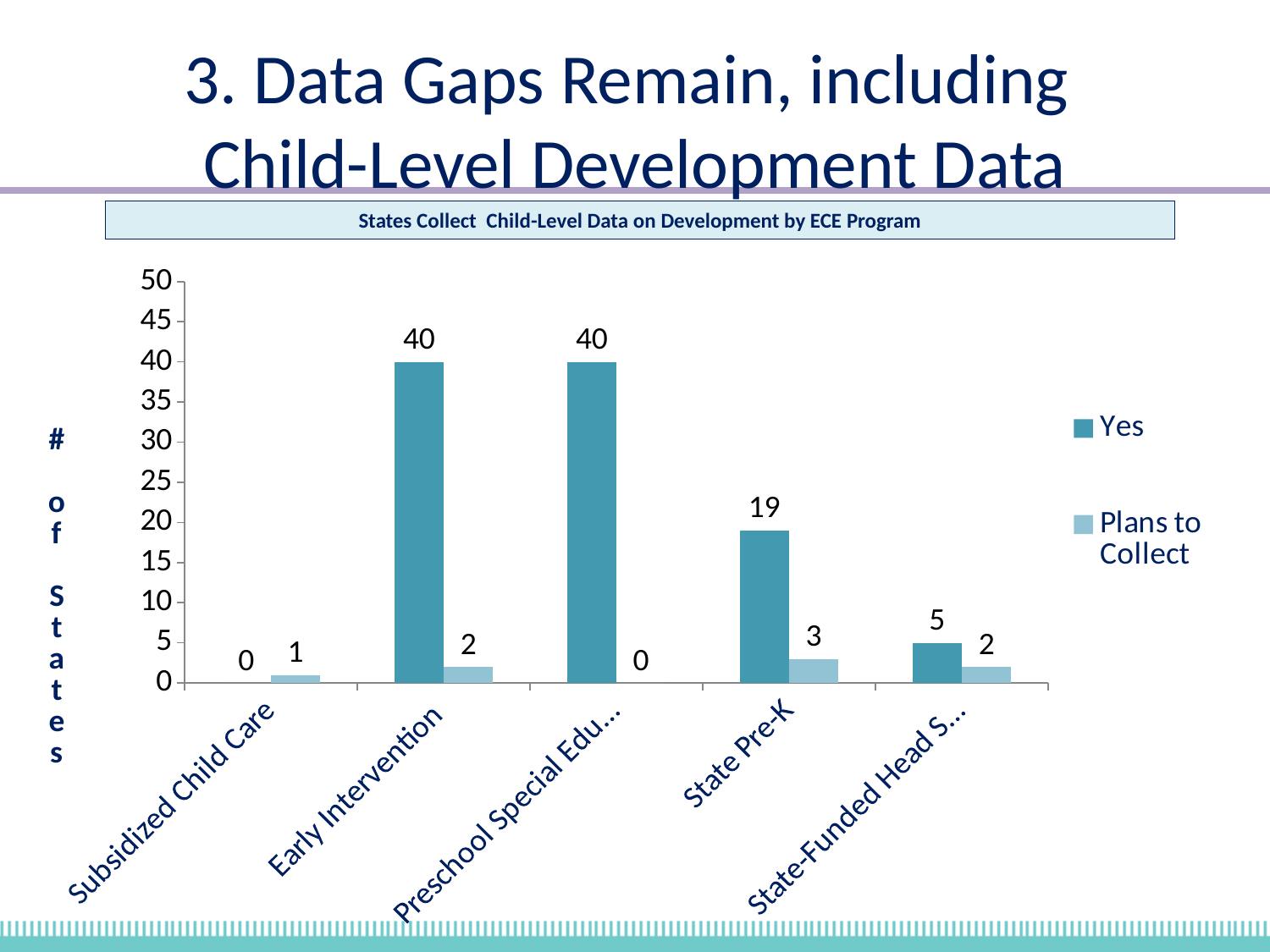
What is the difference between the 'Yes' values for Early Intervention and State Pre-K? 21 What is the 'Yes' value for Early Intervention? 40 What kind of chart is shown on the slide? Bar chart What is the 'Yes' value for State Pre-K? 19 How many series does the legend list? 2 What is the 'Plans to Collect' value for Subsidized Child Care? 1 What is the 'Yes' value for Subsidized Child Care? 0 Which is larger: the 'Yes' value for State Pre-K or the 'Plans to Collect' value for State Pre-K? Yes Which program has the highest 'Plans to Collect' value? State Pre-K How many ECE program categories are shown on the x axis? 5 Which program has the lowest 'Yes' value? Subsidized Child Care What is the 'Plans to Collect' value for State Pre-K? 3